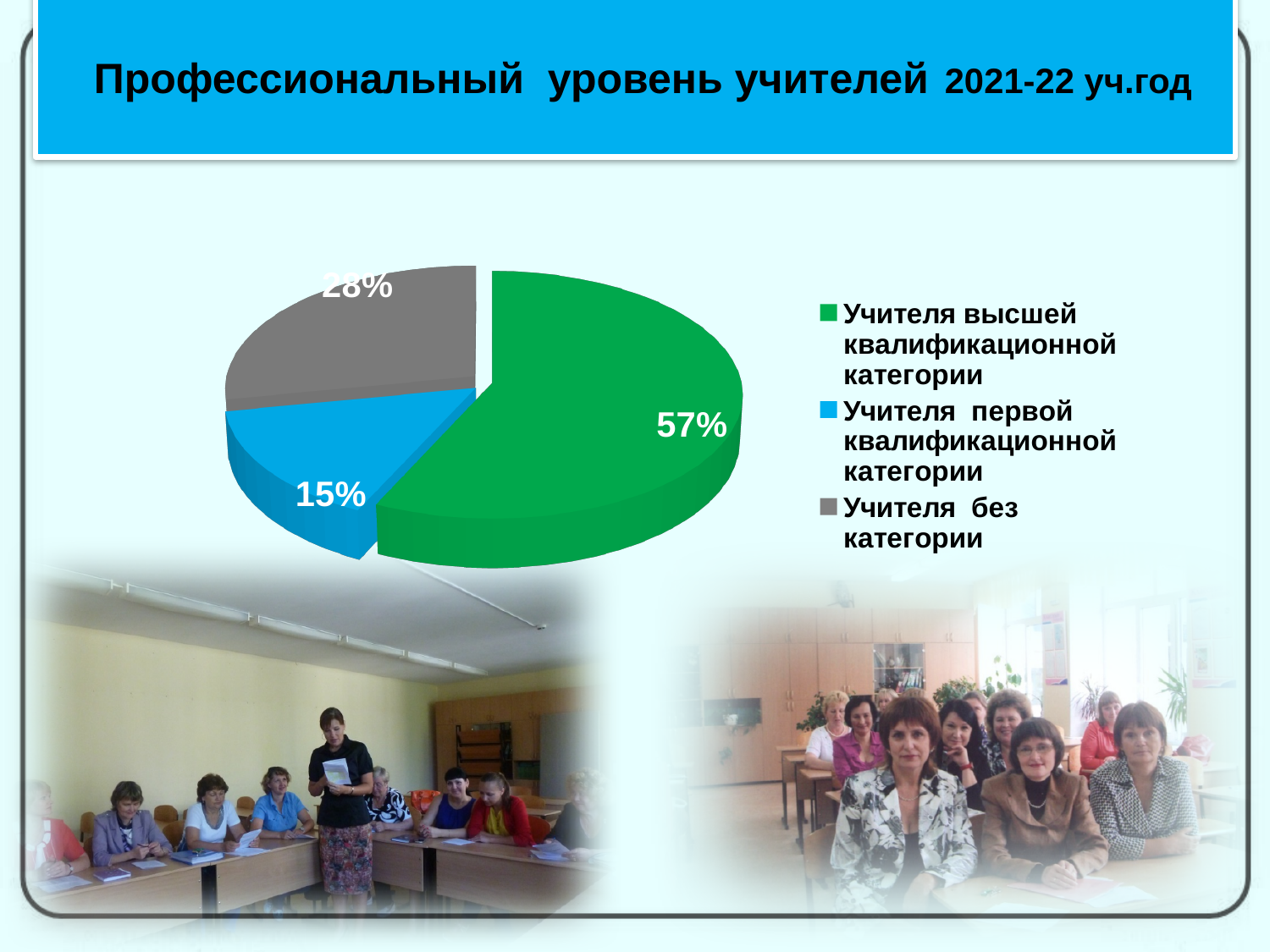
What colour is the slice for Учителя без категории? Grey Which category has the smallest slice of the pie? Учителя первой квалификационной категории What kind of chart is shown on the slide? Pie chart How many categories does the pie chart show? 3 Which is larger: the share for Учителя без категории or the share for Учителя первой квалификационной категории? Учителя без категории What is the difference in percentage points between Учителя высшей квалификационной категории and Учителя без категории? 29 What share of the pie is for Учителя без категории? 28% Which category has the largest slice of the pie? Учителя высшей квалификационной категории What share of the pie is for Учителя первой квалификационной категории? 15% What is the difference in percentage points between Учителя без категории and Учителя первой квалификационной категории? 13 What is the title of the slide containing the chart? Профессиональный уровень учителей 2021-22 уч.год What share of the pie is for Учителя высшей квалификационной категории? 57%